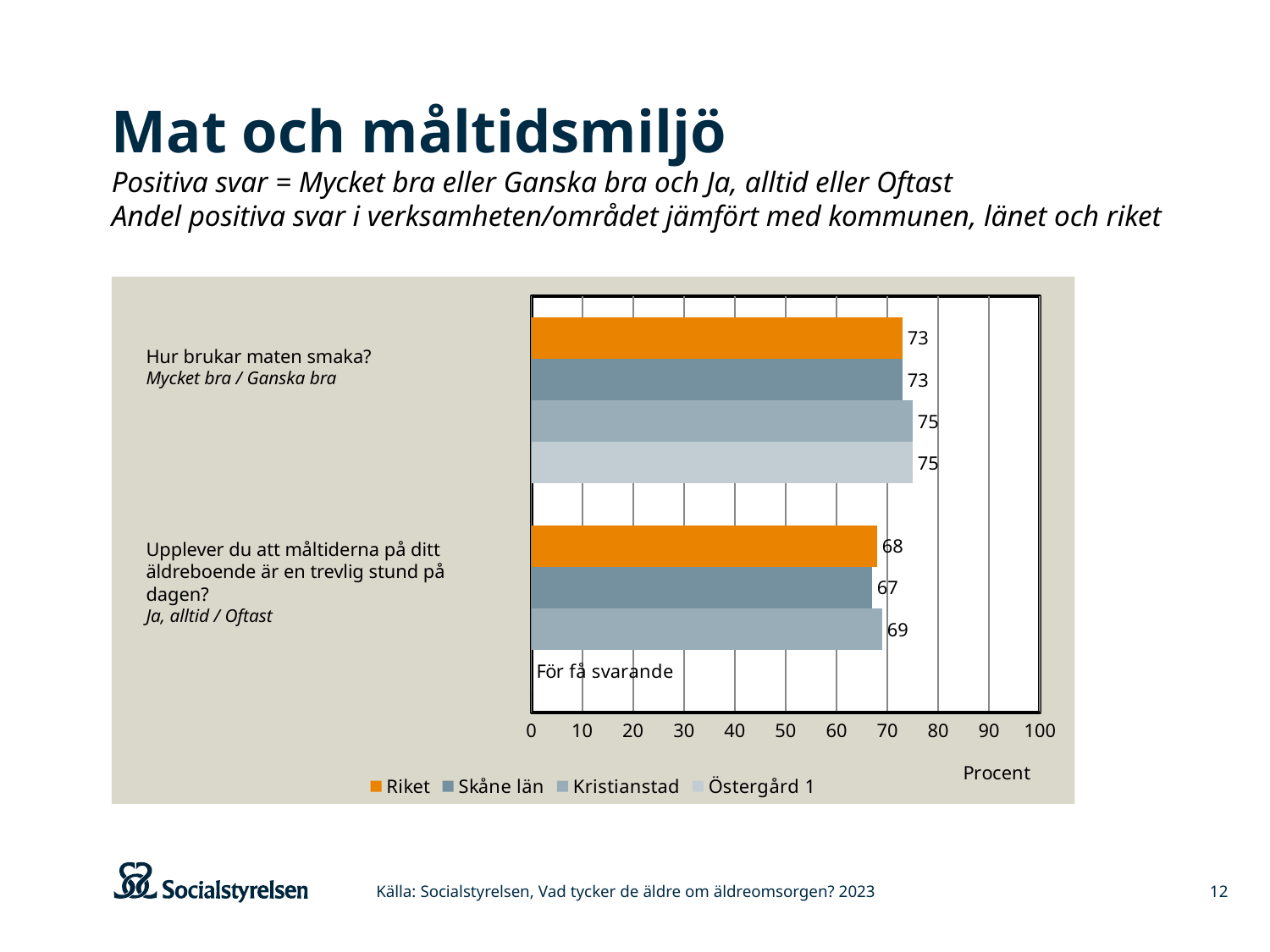
Which colour represents Riket in the legend? orange What is the value for Skåne län for the question "Upplever du att måltiderna på ditt äldreboende är en trevlig stund på dagen?"? 67 What unit is shown on the x axis of the chart? Procent What kind of chart is shown on the slide? bar chart Which series has the lowest value for the question "Upplever du att måltiderna på ditt äldreboende är en trevlig stund på dagen?"? Skåne län What is the difference between the Kristianstad value and the Riket value for the question "Hur brukar maten smaka?"? 2 How many series does the legend list? 4 Is the value for Riket for the question "Upplever du att måltiderna på ditt äldreboende är en trevlig stund på dagen?" greater or less than 70? less What is the value for Kristianstad for the question "Upplever du att måltiderna på ditt äldreboende är en trevlig stund på dagen?"? 69 What is shown for Östergård 1 for the question "Upplever du att måltiderna på ditt äldreboende är en trevlig stund på dagen?"? För få svarande What is the value for Östergård 1 for the question "Hur brukar maten smaka?"? 75 What is the value for Riket for the question "Hur brukar maten smaka?"? 73